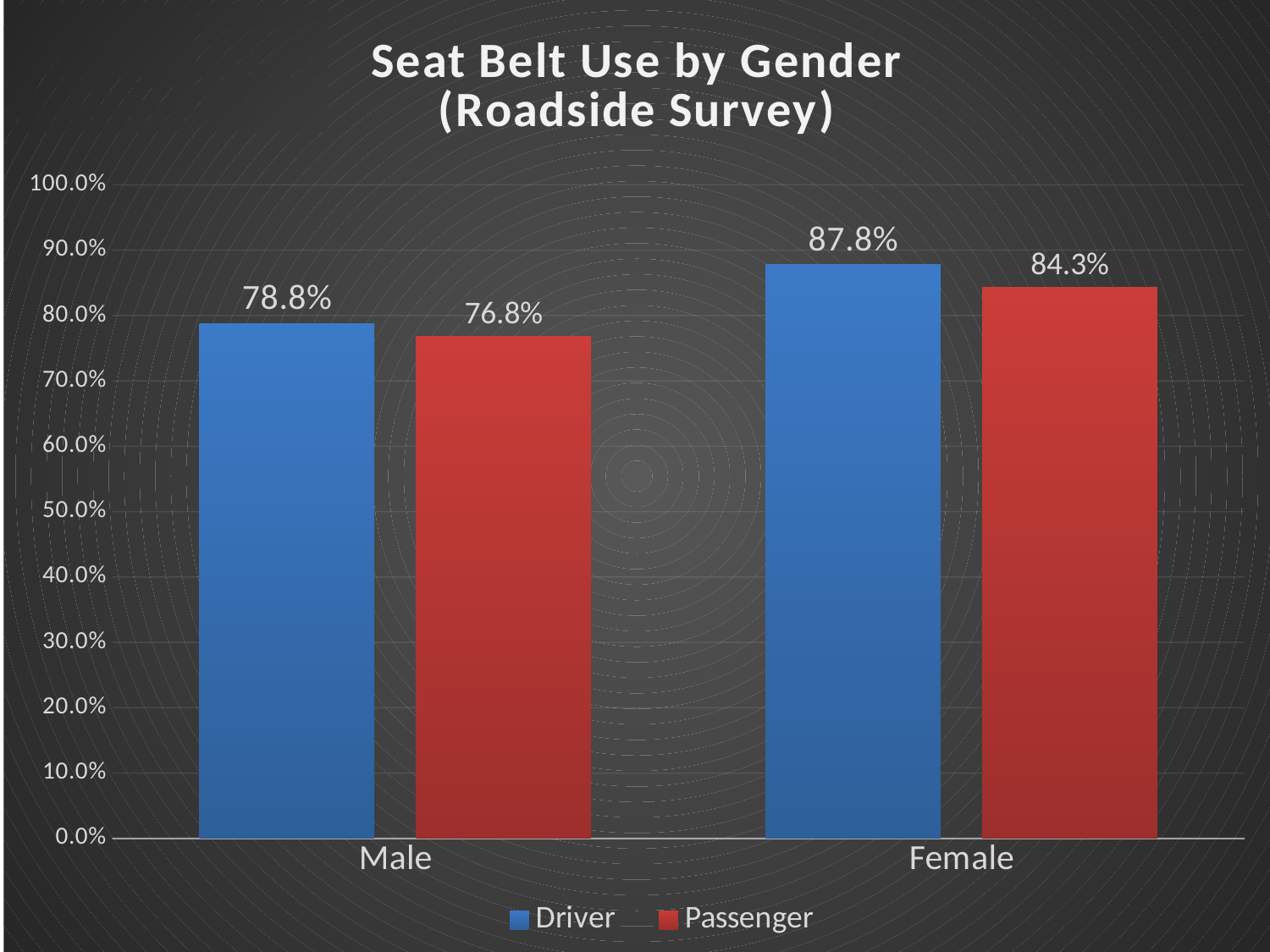
What kind of chart is shown on the slide? Bar chart What is the seat belt use rate for male passengers? 76.8% How many series does the legend list? 2 Is the seat belt use rate higher for female drivers or female passengers? Female drivers Which gender has the highest seat belt use rate among drivers? Female What is the difference between the female driver and male driver seat belt use rates? 9.0% What is the seat belt use rate for male drivers? 78.8% What is the seat belt use rate for female passengers? 84.3% How many gender categories are shown on the x axis? 2 Which bar shows the lowest seat belt use rate on the chart? Male Passenger Is the seat belt use rate for male passengers greater or less than 80.0%? less What colour represents the Passenger series? Red